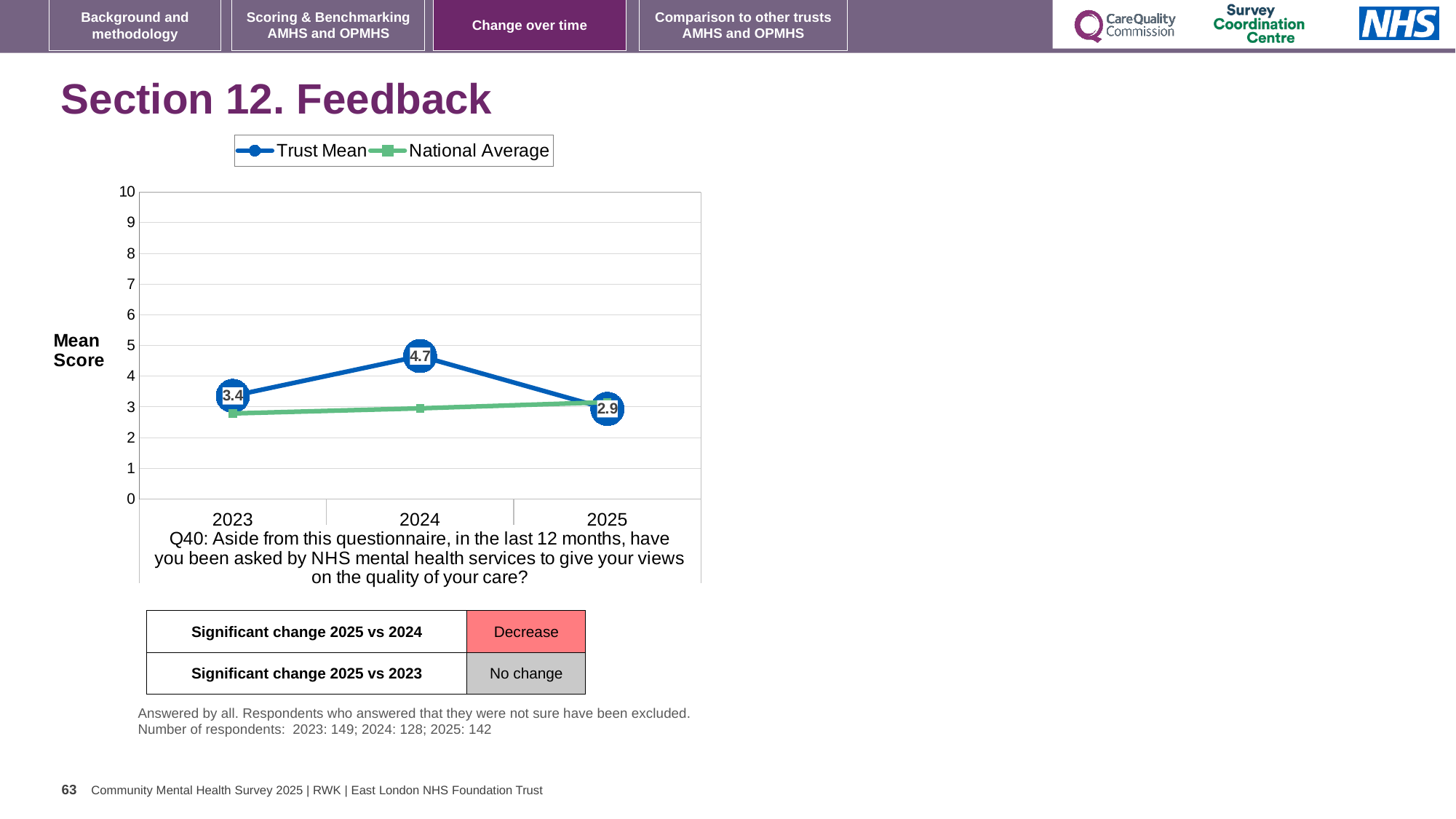
In 2024, which series has the higher value, Trust Mean or National Average? Trust Mean What kind of chart is shown on the slide? Line chart What is the Trust Mean score for 2024? 4.7 Is the National Average value for 2024 greater or less than 5? less What is the difference between the Trust Mean in 2024 and in 2025? 1.8 How many years are shown on the x axis? 3 What is the difference between the Trust Mean in 2024 and in 2023? 1.3 In which year is the Trust Mean highest? 2024 What is the Trust Mean score for 2023? 3.4 How many series does the legend list? 2 What is the Trust Mean score for 2025? 2.9 In which year is the Trust Mean lowest? 2025